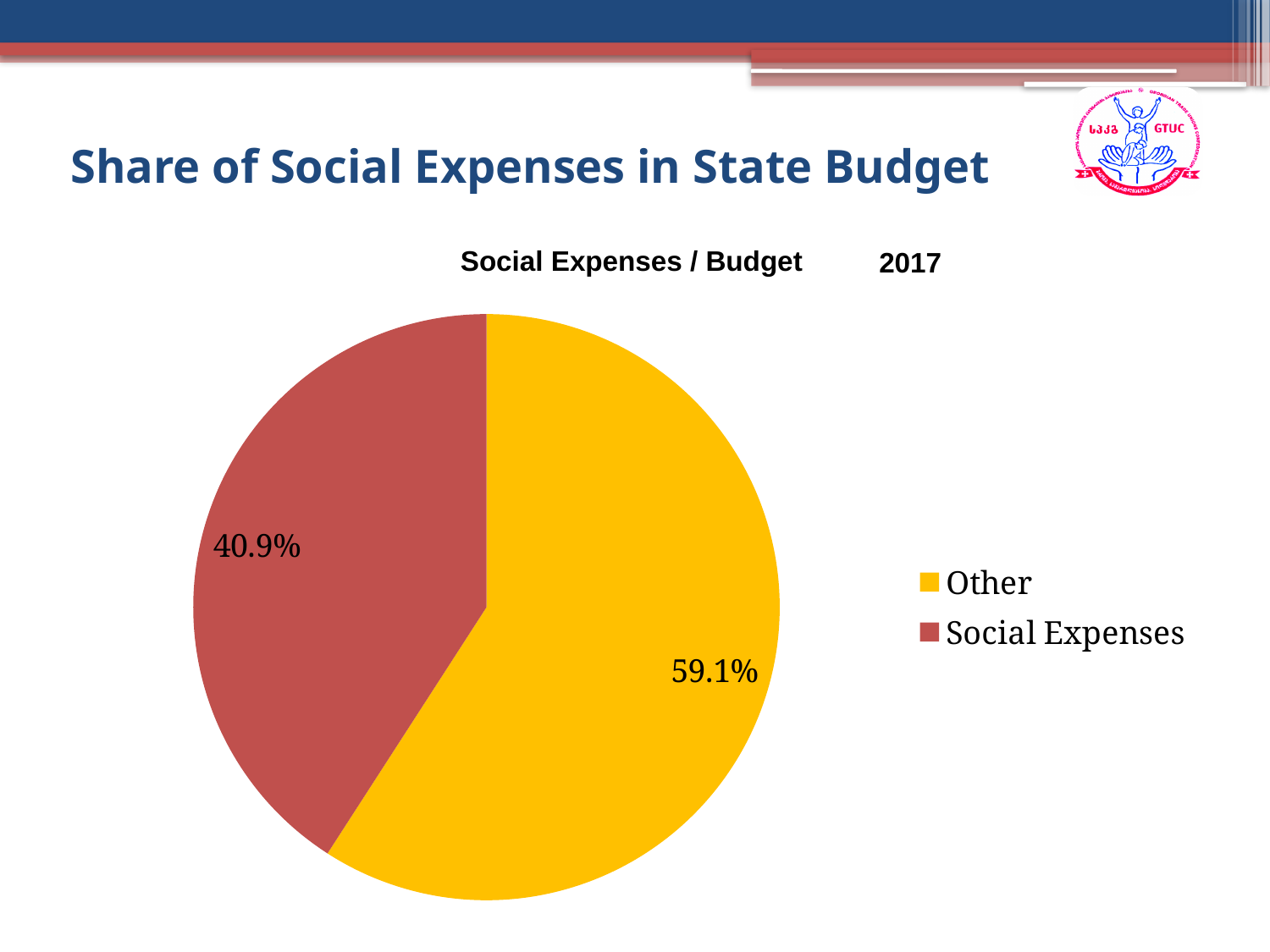
Which is larger, the Other slice or the Social Expenses slice? Other Which slice of the pie is the largest? Other What is the title of the chart? Social Expenses / Budget How many entries does the legend list? 2 What share of the pie does Social Expenses represent? 40.9% What kind of chart is shown on the slide? Pie chart Which slice of the pie is the smallest? Social Expenses Is the share for Social Expenses greater or less than 50%? less What share of the pie does Other represent? 59.1% How many slices does the pie chart have? 2 What is the difference in percentage points between the Other slice and the Social Expenses slice? 18.2 What colour is the Social Expenses slice? Red